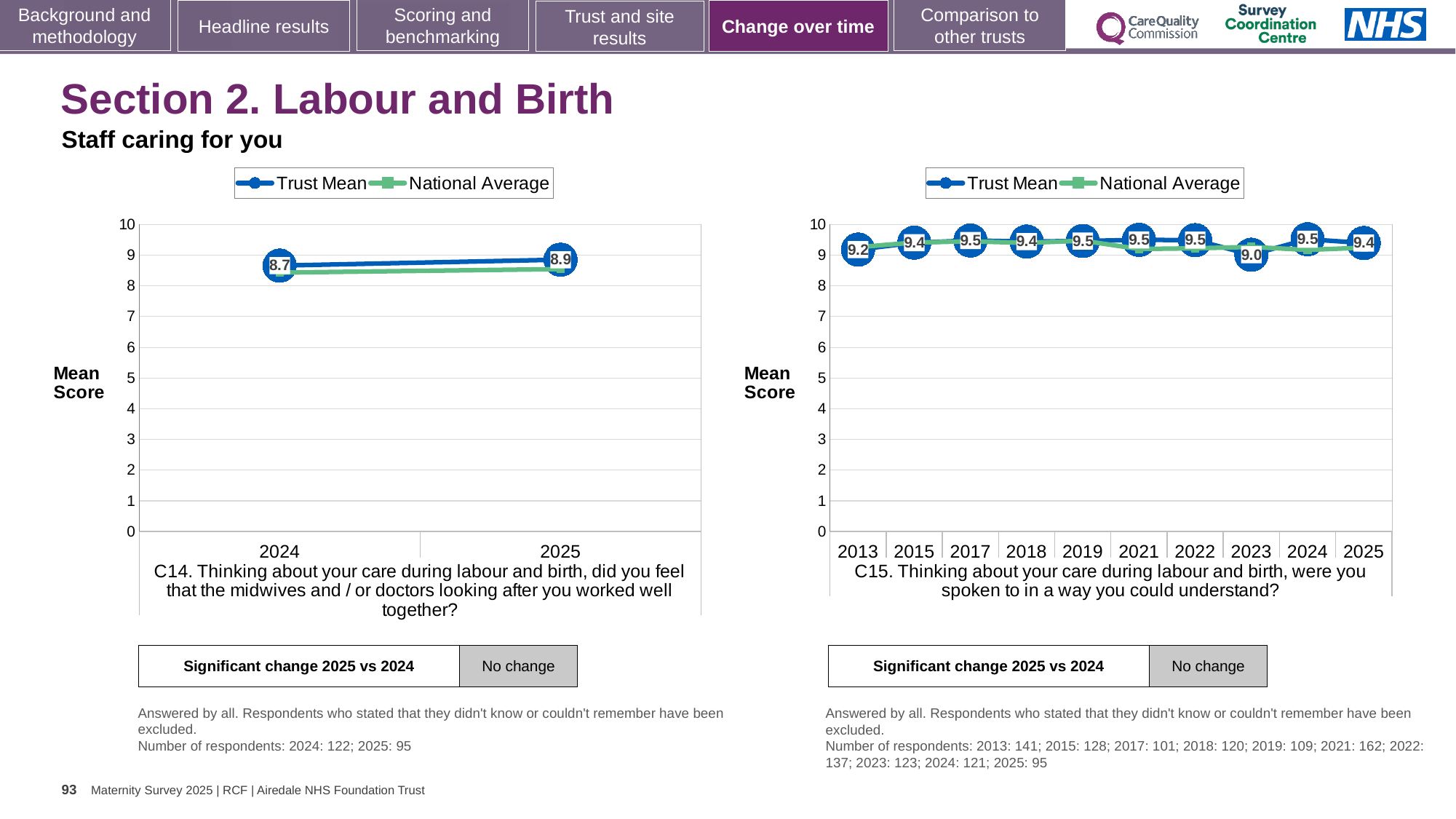
On the right chart (C15), what is the Trust Mean for 2023? 9.0 On the right chart (C15), which year has the lowest Trust Mean? 2023 On the left chart (C14), by how much did the Trust Mean change from 2024 to 2025? 0.2 On the right chart (C15), what is the Trust Mean for 2013? 9.2 On the left chart (C14), what is the Trust Mean for 2025? 8.9 What type of chart is the right chart (C15)? line chart On the right chart (C15), is the Trust Mean for 2025 greater or less than 8? greater On the right chart (C15), what is the difference between the Trust Mean in 2024 and in 2023? 0.5 On the left chart (C14), does the Trust Mean rise or fall from 2024 to 2025? rise On the left chart (C14), what is the Trust Mean for 2024? 8.7 How many series does the legend of the left chart list? 2 On the right chart (C15), how many years are plotted on the x axis? 10